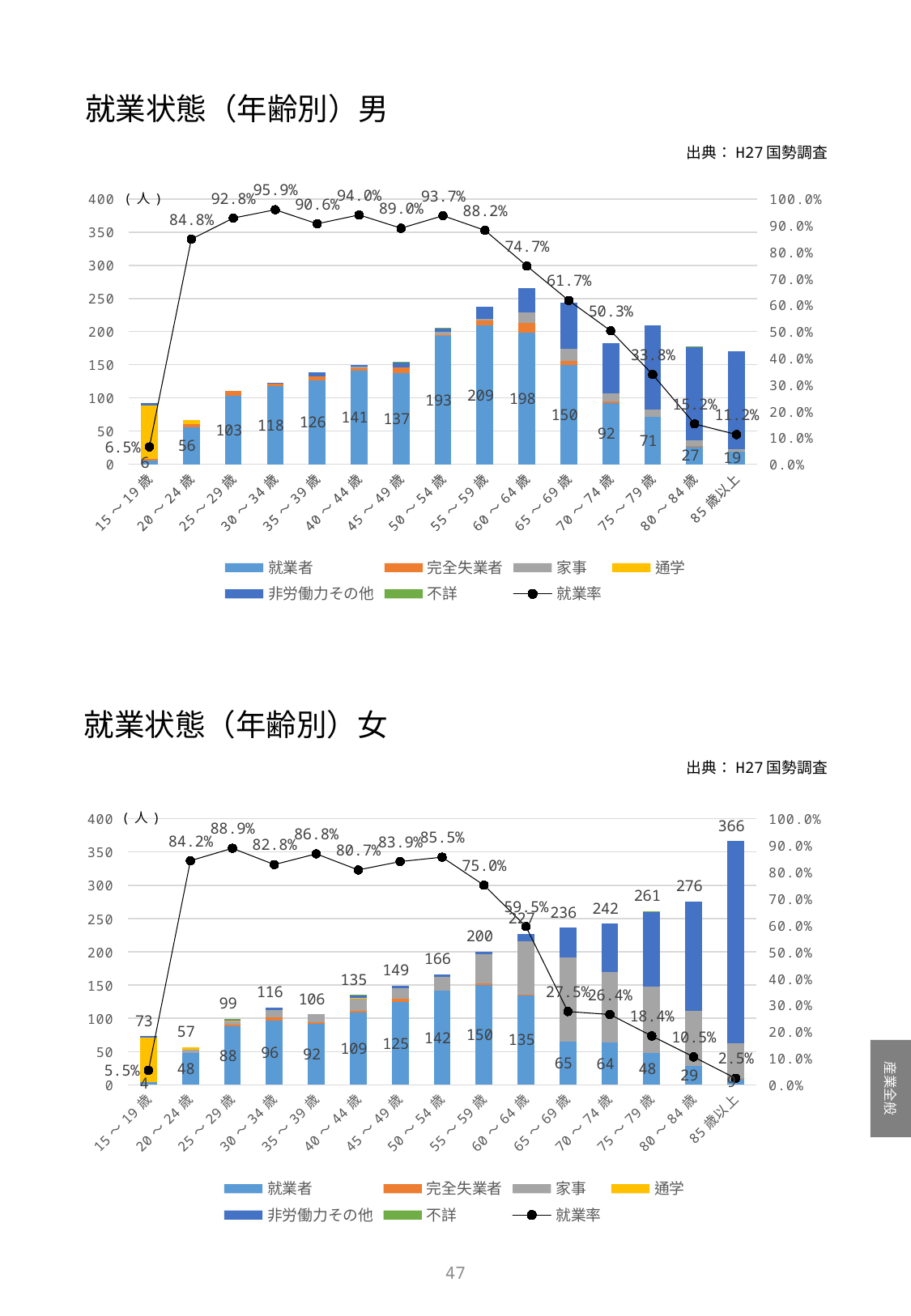
In the 就業状態（年齢別）女 chart, is the 就業率 for 65～69歳 or 70～74歳 larger? 65～69歳 In the 就業状態（年齢別）男 chart, how many series does the legend list? 7 In the 就業状態（年齢別）女 chart, how many age groups are shown on the x axis? 15 In the 就業状態（年齢別）女 chart, what is the total of the stacked bar for 85歳以上? 366 In the 就業状態（年齢別）男 chart, what is the 就業者 value for 55～59歳? 209 In the 就業状態（年齢別）男 chart, what is the 就業率 for 30～34歳? 95.9% In the 就業状態（年齢別）女 chart, which age group has the highest 就業者 value? 55～59歳 In the 就業状態（年齢別）男 chart, what is the difference between the 就業者 values for 55～59歳 and 60～64歳? 11 In the 就業状態（年齢別）男 chart, which age group has the highest 就業率? 30～34歳 In the 就業状態（年齢別）男 chart, which age group has the lowest 就業者 value? 15～19歳 In the 就業状態（年齢別）女 chart, does the 就業率 rise or fall from 60～64歳 to 85歳以上? fall In the 就業状態（年齢別）女 chart, what is the 就業率 for 60～64歳? 59.5%